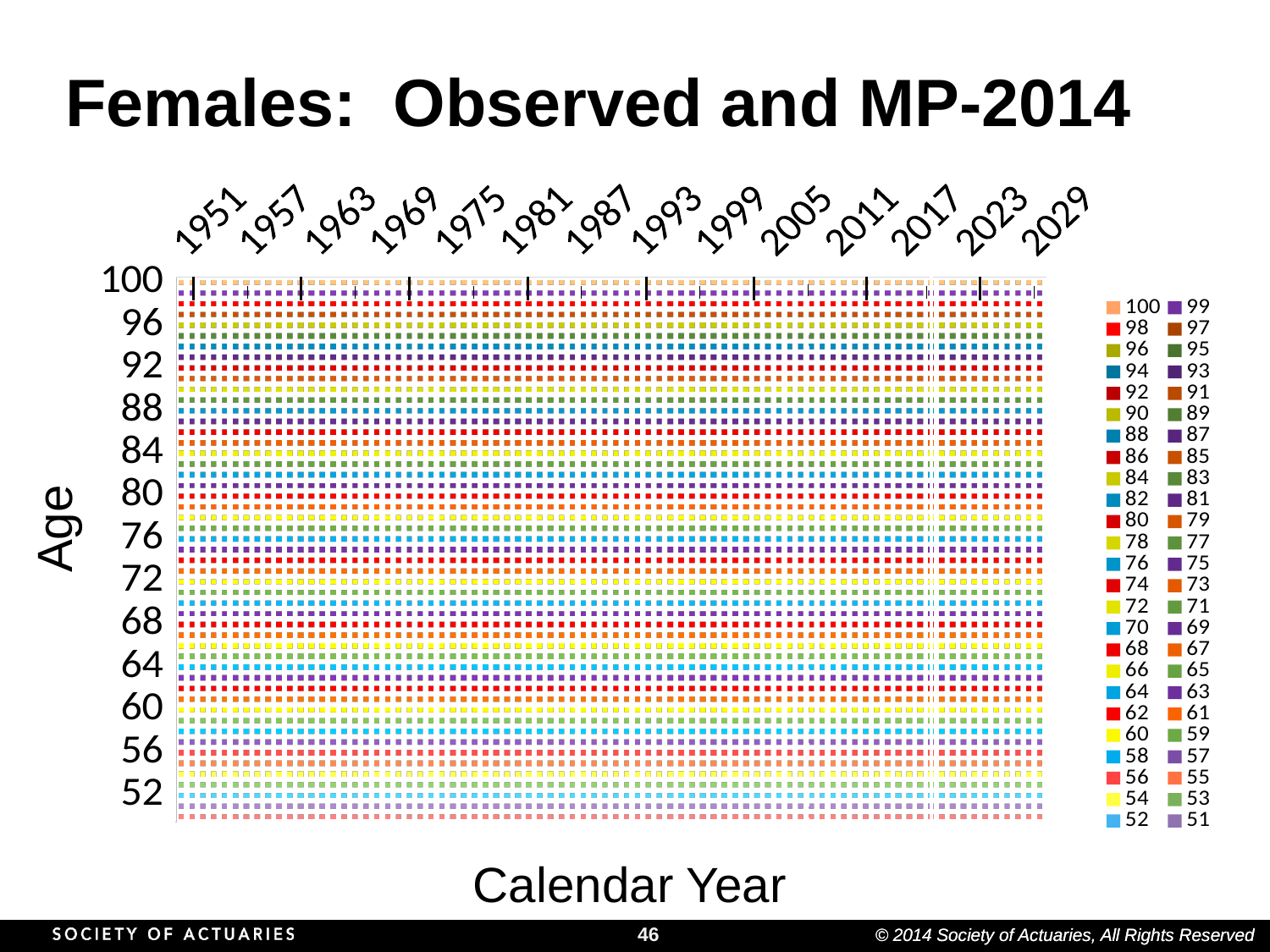
What is the highest age shown on the y axis? 100 What is the title of the chart? Females: Observed and MP-2014 What is the label of the x axis? Calendar Year How many year labels are shown along the x axis? 14 What is the last year label on the x axis? 2029 What is the lowest age series listed in the legend? 51 What kind of chart is shown on the slide? scatter chart How many series does the legend list? 50 What is the highest age series listed in the legend? 100 What is the first year label on the x axis? 1951